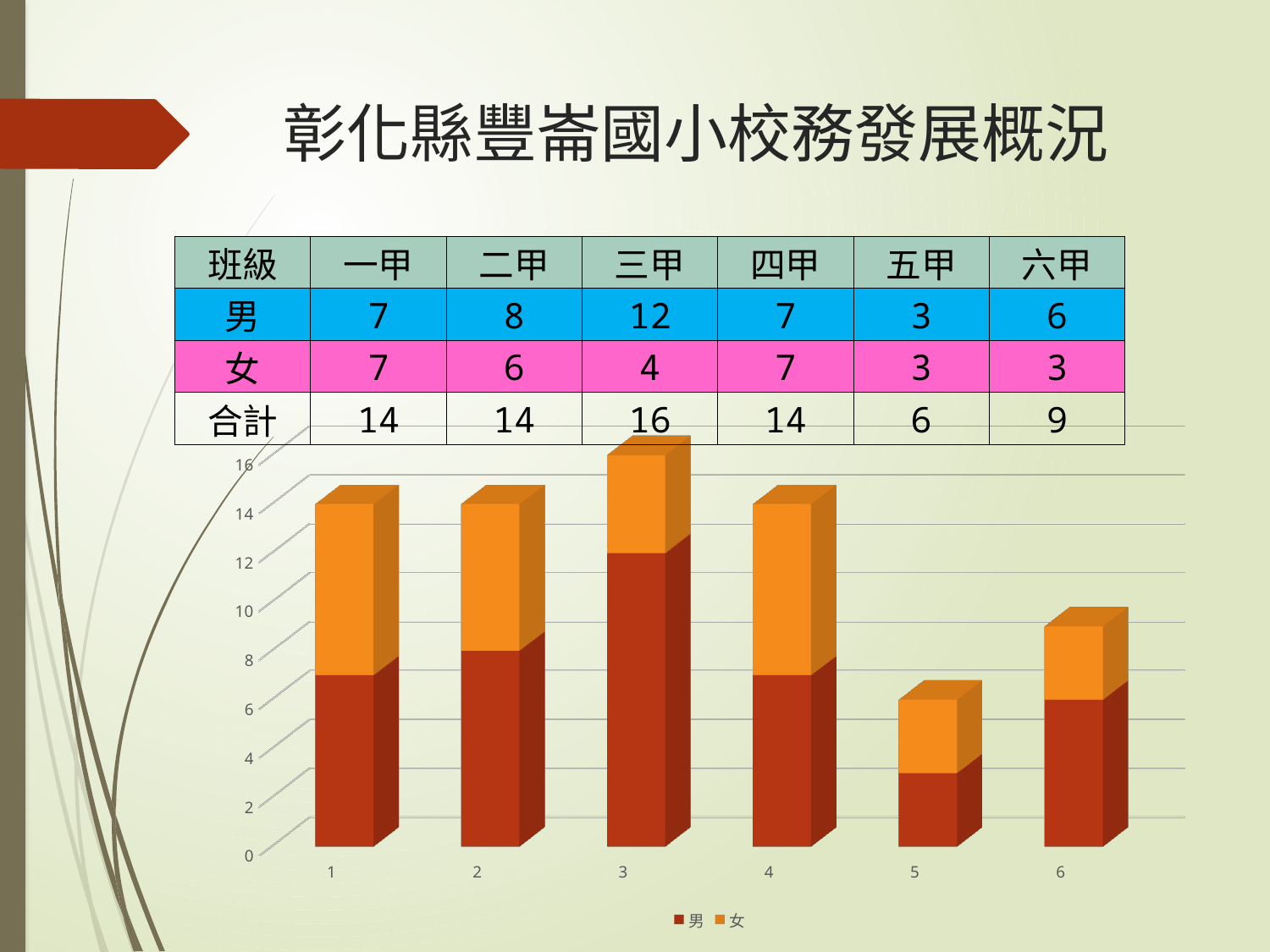
Which category has the tallest stacked bar in the chart? 3 What kind of chart is shown on the slide? stacked bar chart What is the difference between the 男 value and the 女 value for category 3? 8 Is the total of the stacked bar for category 5 greater or less than 8? less What is the value of the 男 series for category 3 in the chart? 12 How many series does the chart legend list? 2 Which category has the shortest stacked bar in the chart? 5 What is the value of the 女 series for category 2 in the chart? 6 What are the two series named in the chart legend? 男 and 女 What is the total height of the stacked bar for category 6? 9 How many categories are shown along the x axis of the chart? 6 Which is larger for category 6: the 男 value or the 女 value? 男